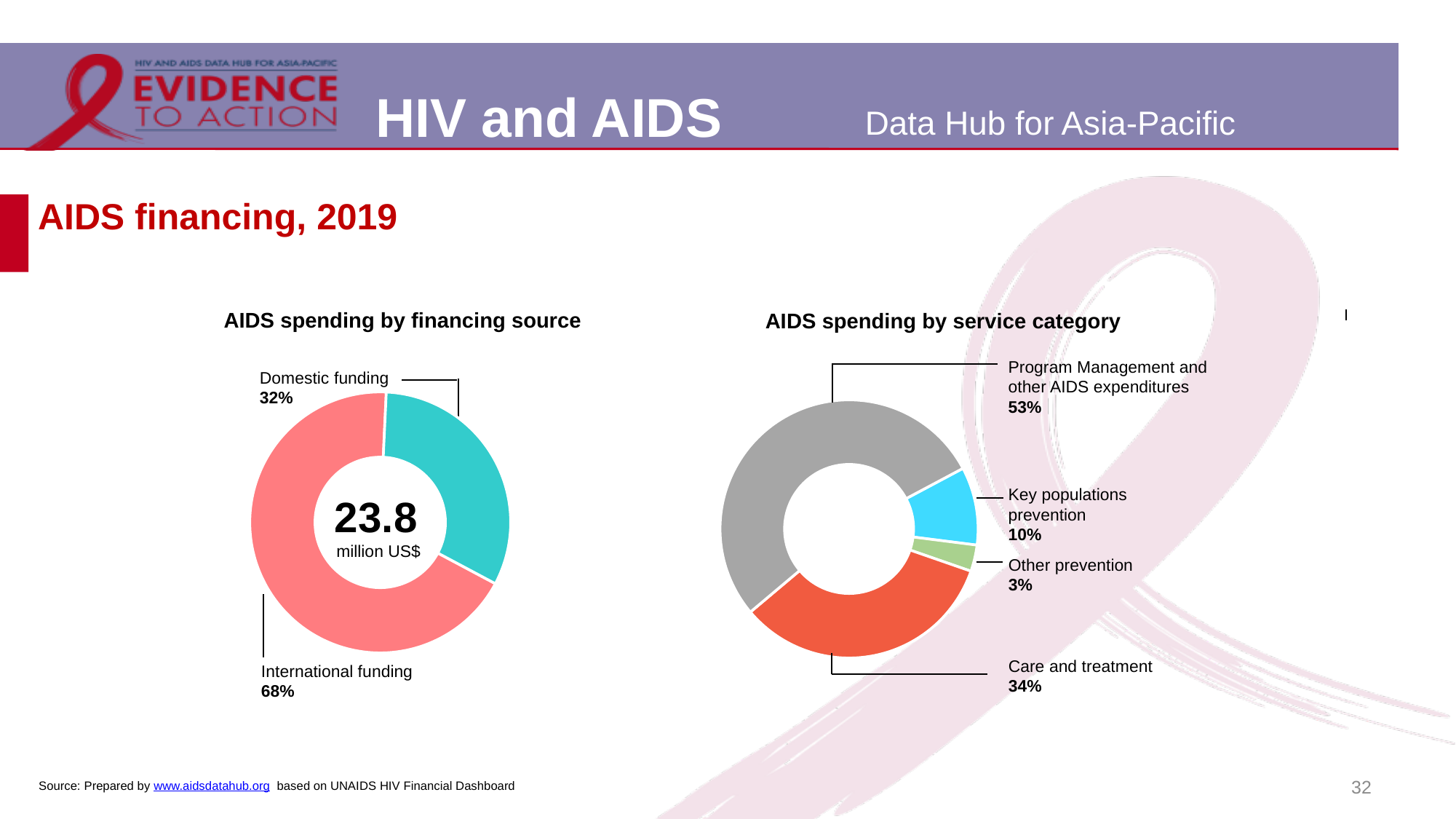
In the 'AIDS spending by financing source' chart, what is the difference in percentage points between International funding and Domestic funding? 36 percentage points In the 'AIDS spending by service category' chart, what is the difference in percentage points between Program Management and other AIDS expenditures and Care and treatment? 19 percentage points In the 'AIDS spending by service category' chart, how many service categories are shown? 4 In the 'AIDS spending by financing source' chart, what total amount is shown in the centre of the donut? 23.8 million US$ What type of chart is used for 'AIDS spending by financing source'? Donut (pie) chart In the 'AIDS spending by service category' chart, which service category has the smallest share? Other prevention In the 'AIDS spending by financing source' chart, what share is International funding? 68% In the 'AIDS spending by service category' chart, which service category has the largest share? Program Management and other AIDS expenditures In the 'AIDS spending by service category' chart, what share is Care and treatment? 34% In the 'AIDS spending by service category' chart, what share is Key populations prevention? 10% In the 'AIDS spending by financing source' chart, what share is Domestic funding? 32% In the 'AIDS spending by financing source' chart, which financing source has the larger share? International funding